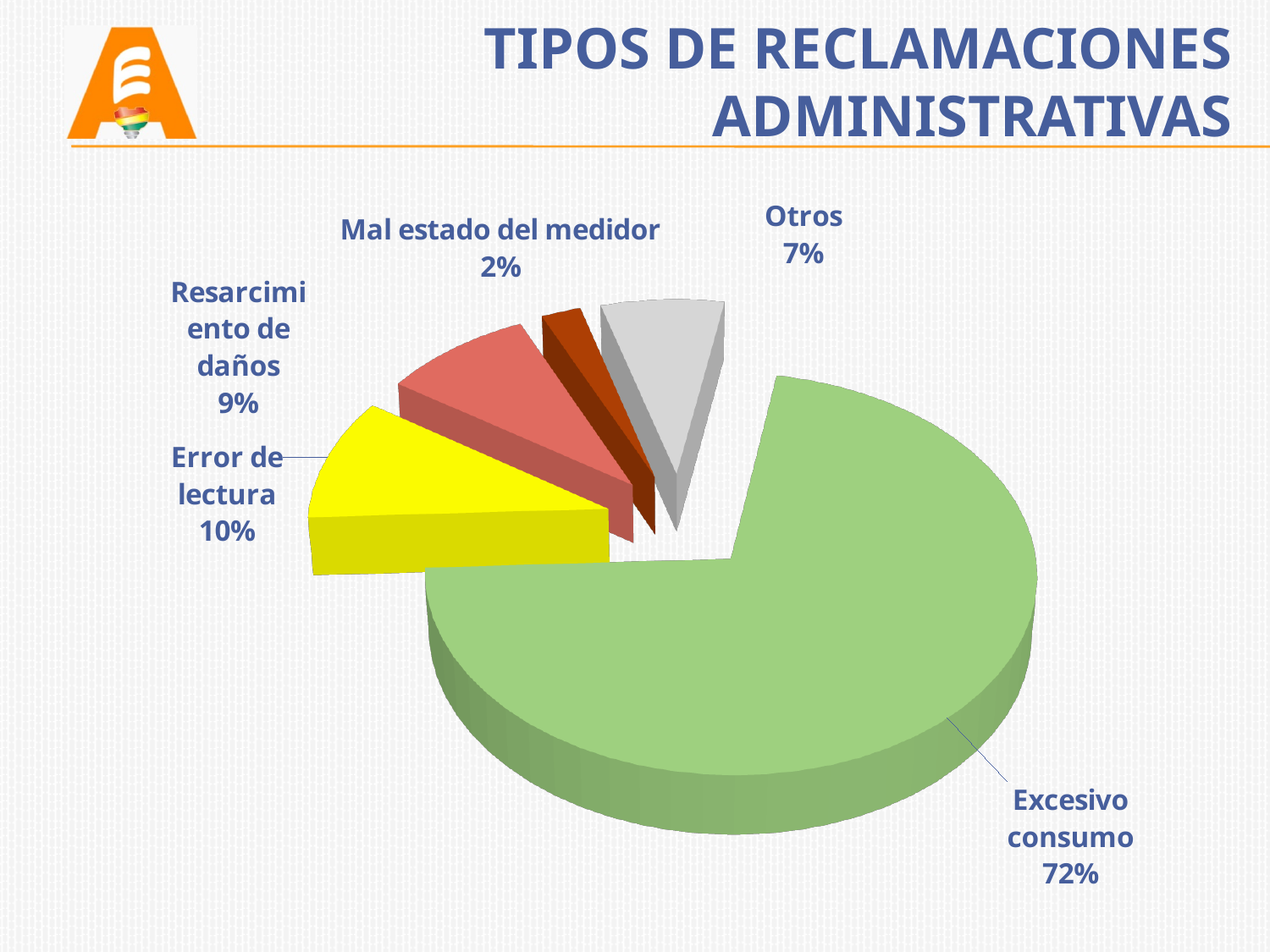
Which category has the largest share of the pie? Excesivo consumo How many categories are shown in the pie chart? 5 What is the value shown for Resarcimiento de daños? 9% What is the difference between the shares of Excesivo consumo and Error de lectura? 62% What is the value shown for Error de lectura? 10% What kind of chart is shown on the slide? Pie chart What is the value shown for Mal estado del medidor? 2% What is the title of the slide containing the chart? TIPOS DE RECLAMACIONES ADMINISTRATIVAS What is the value shown for Otros? 7% What share of the pie does Excesivo consumo represent? 72% Which category has the smallest share of the pie? Mal estado del medidor Which is larger, the share for Otros or the share for Resarcimiento de daños? Resarcimiento de daños